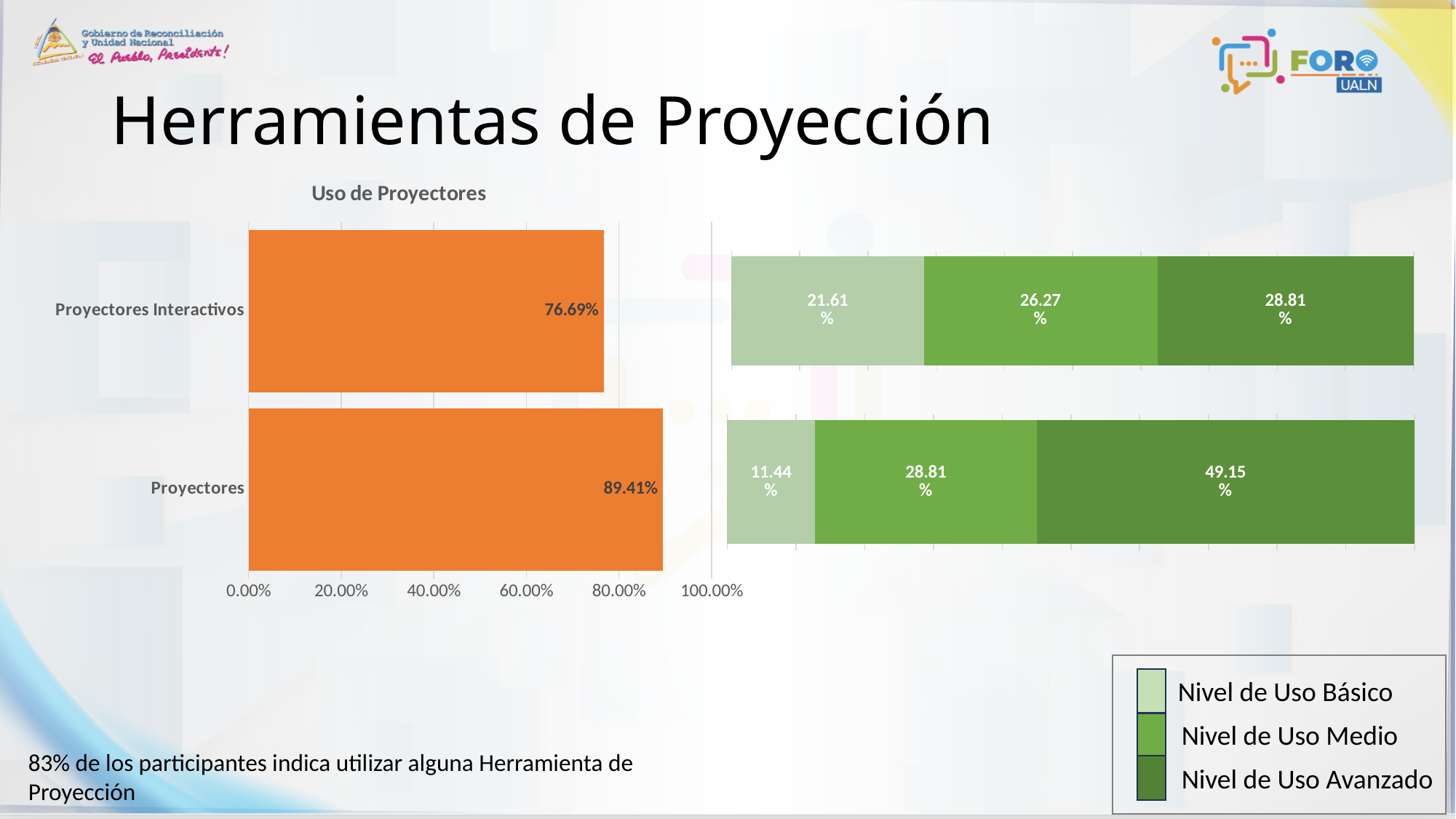
In the 'Uso de Proyectores' chart, what is the difference between the value for Proyectores and the value for Proyectores Interactivos? 12.72 percentage points In the stacked bar chart on the right, which is larger for the bottom bar (Proyectores): Nivel de Uso Básico or Nivel de Uso Avanzado? Nivel de Uso Avanzado In the stacked bar chart on the right, how many series does the legend list? 3 In the stacked bar chart on the right, what is the Nivel de Uso Medio value for the bottom bar (Proyectores)? 28.81% In the 'Uso de Proyectores' chart, what is the value for Proyectores Interactivos? 76.69% In the stacked bar chart on the right, what is the Nivel de Uso Avanzado value for the bottom bar (Proyectores)? 49.15% In the 'Uso de Proyectores' chart, which category has the higher value? Proyectores In the 'Uso de Proyectores' chart, what is the value for Proyectores? 89.41% In the stacked bar chart on the right, what is the total of the top bar (Proyectores Interactivos)? 76.69% In the stacked bar chart on the right, what is the Nivel de Uso Básico value for the top bar (Proyectores Interactivos)? 21.61% In the 'Uso de Proyectores' chart, how many categories are shown? 2 What kind of chart is the 'Uso de Proyectores' chart? Bar chart